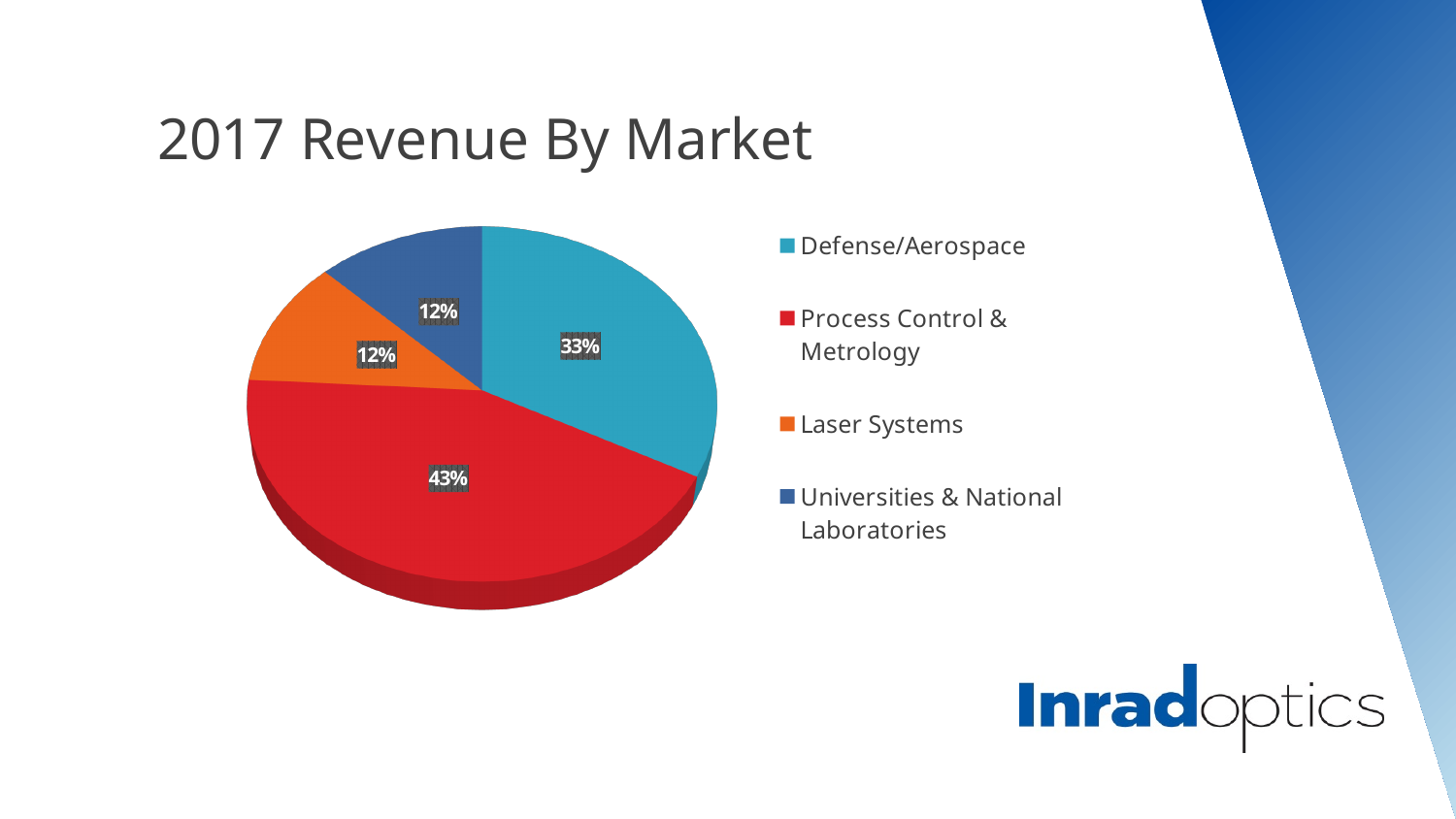
Which market accounts for the largest share of 2017 revenue? Process Control & Metrology Which market is shown in red in the pie chart? Process Control & Metrology Which is larger, the Defense/Aerospace share or the Laser Systems share? Defense/Aerospace What share of 2017 revenue came from Process Control & Metrology? 43% What share of 2017 revenue came from Laser Systems? 12% What share of 2017 revenue came from Universities & National Laboratories? 12% What kind of chart is shown on the slide? Pie chart What is the combined share of Laser Systems and Universities & National Laboratories? 24% What is the difference in percentage points between the Process Control & Metrology share and the Defense/Aerospace share? 10 How many market categories are shown in the pie chart? 4 What is the title of the chart? 2017 Revenue By Market